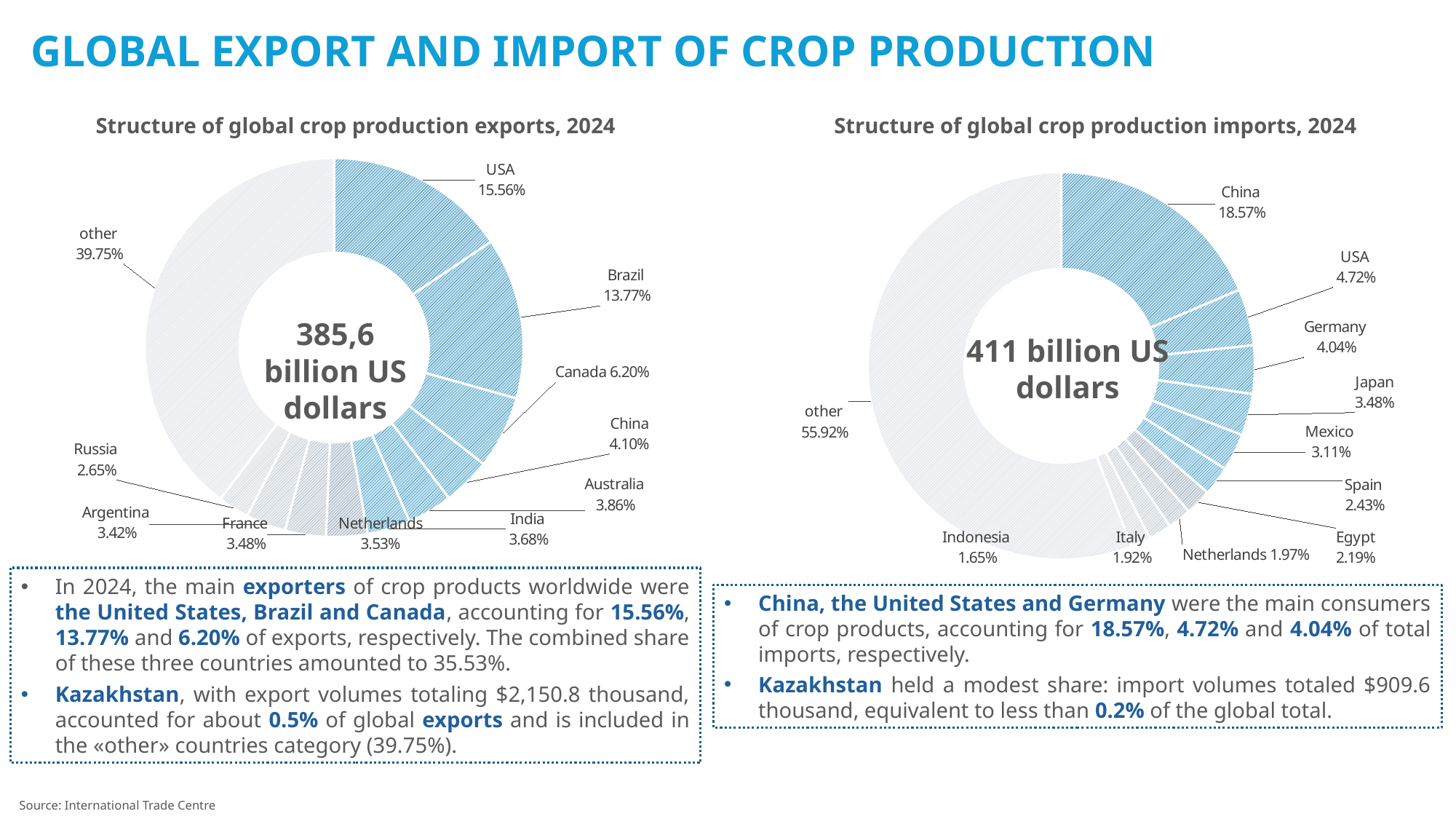
In the 'Structure of global crop production imports, 2024' chart, what share does Germany hold? 4.04% What total value is shown in the centre of the 'Structure of global crop production imports, 2024' chart? 411 billion US dollars In the 'Structure of global crop production exports, 2024' chart, which individual country has the largest share? USA In the 'Structure of global crop production exports, 2024' chart, what is the difference between the shares of USA and Brazil? 1.79% In the 'Structure of global crop production imports, 2024' chart, which has a larger share, Japan or Mexico? Japan In the 'Structure of global crop production imports, 2024' chart, what share does Indonesia hold? 1.65% What type of chart is used for 'Structure of global crop production imports, 2024'? Pie (donut) chart In the 'Structure of global crop production exports, 2024' chart, what share does Brazil hold? 13.77% In the 'Structure of global crop production exports, 2024' chart, what share does Russia hold? 2.65% In the 'Structure of global crop production imports, 2024' chart, which individual country has the smallest share? Indonesia How many slices does the 'Structure of global crop production exports, 2024' chart have, including 'other'? 11 What total value is shown in the centre of the 'Structure of global crop production exports, 2024' chart? 385,6 billion US dollars